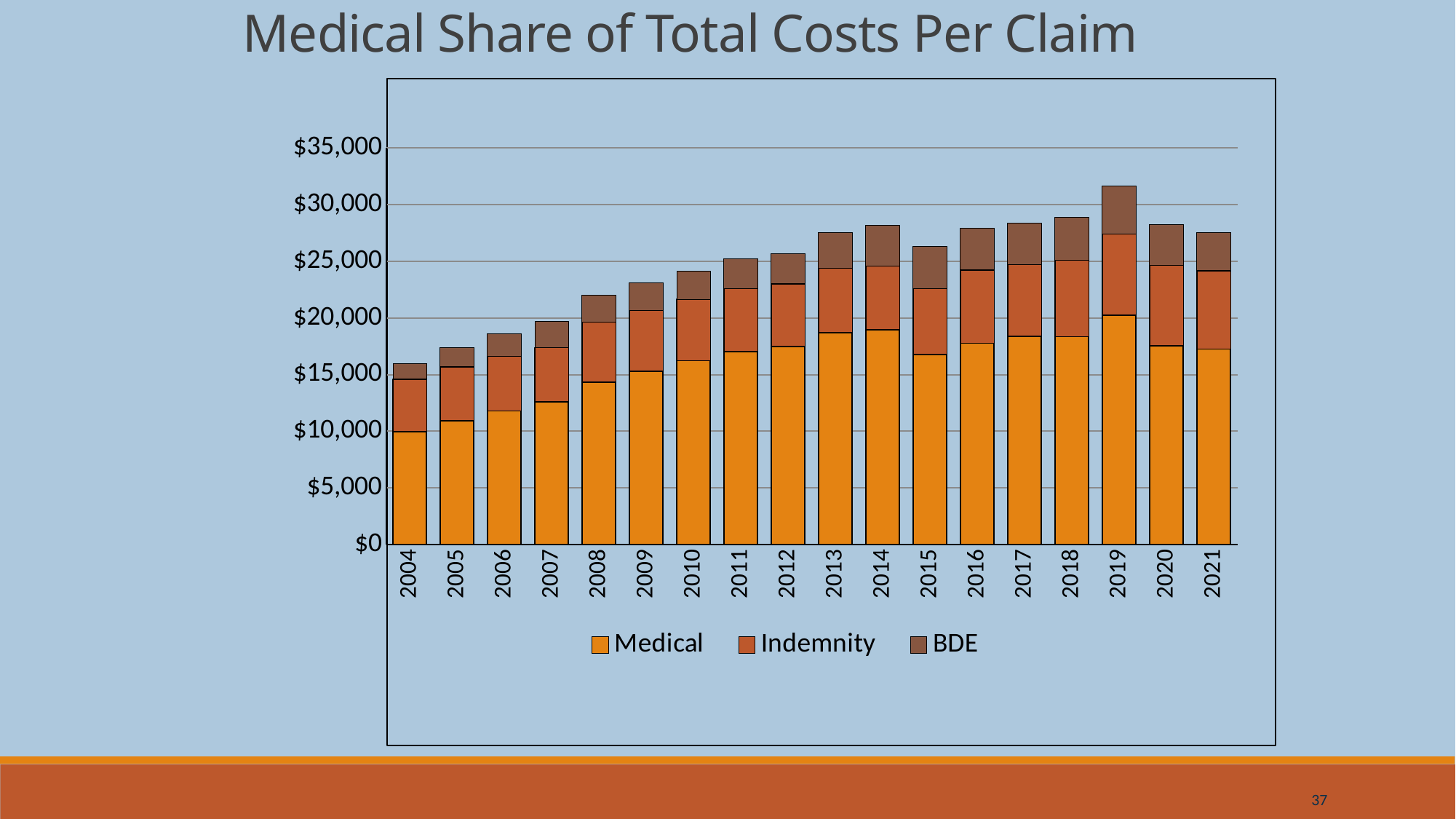
How many years are shown on the x axis of the chart? 18 Is the total bar for 2004 greater or less than $20,000? less Which year has the larger total bar, 2019 or 2020? 2019 How many series does the legend list? 3 What kind of chart is shown on the slide? Stacked bar chart What is the title of the chart? Medical Share of Total Costs Per Claim Do the total costs per claim generally rise or fall from 2004 to 2019? rise Which year has the shortest total bar? 2004 Is the Medical value for 2013 greater or less than $15,000? greater Which year has the tallest total bar? 2019 Is the total bar for 2019 greater or less than $30,000? greater